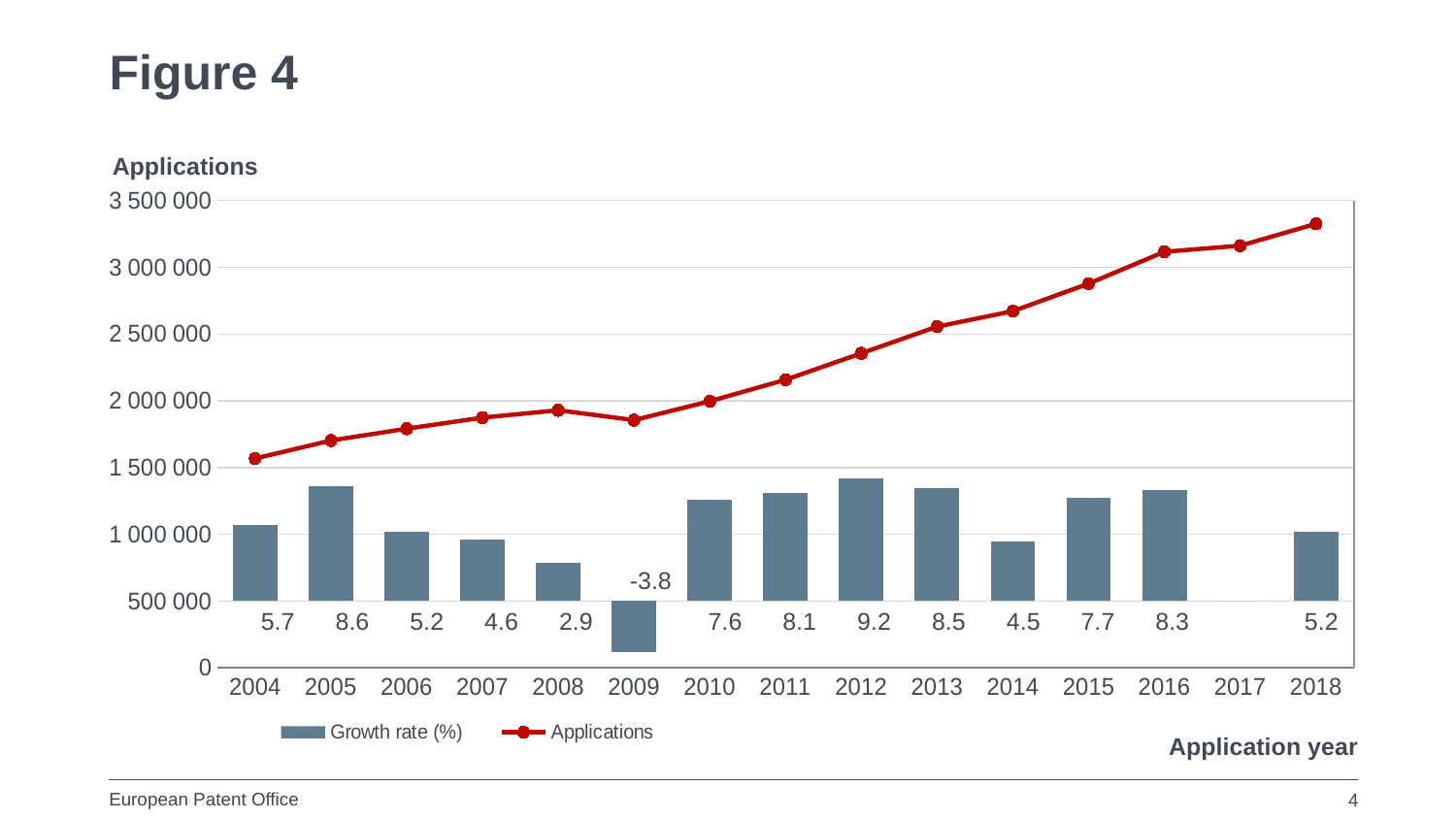
Which application year has the highest growth rate (%)? 2012 Do the Applications values rise or fall from 2010 to 2018? rise Is the number of applications for 2018 greater or less than 3 000 000? greater How many series does the legend list? 2 What is the growth rate (%) shown for 2009? -3.8 Is the number of applications for 2009 greater or less than 2 000 000? less Which year has the larger growth rate (%), 2011 or 2013? 2013 Which application year has the lowest growth rate (%)? 2009 How many application years are shown on the x axis? 15 What is the growth rate (%) shown for 2012? 9.2 What kind of chart is shown on the slide? Combination bar and line chart By how much does the growth rate (%) for 2005 exceed that for 2004? 2.9